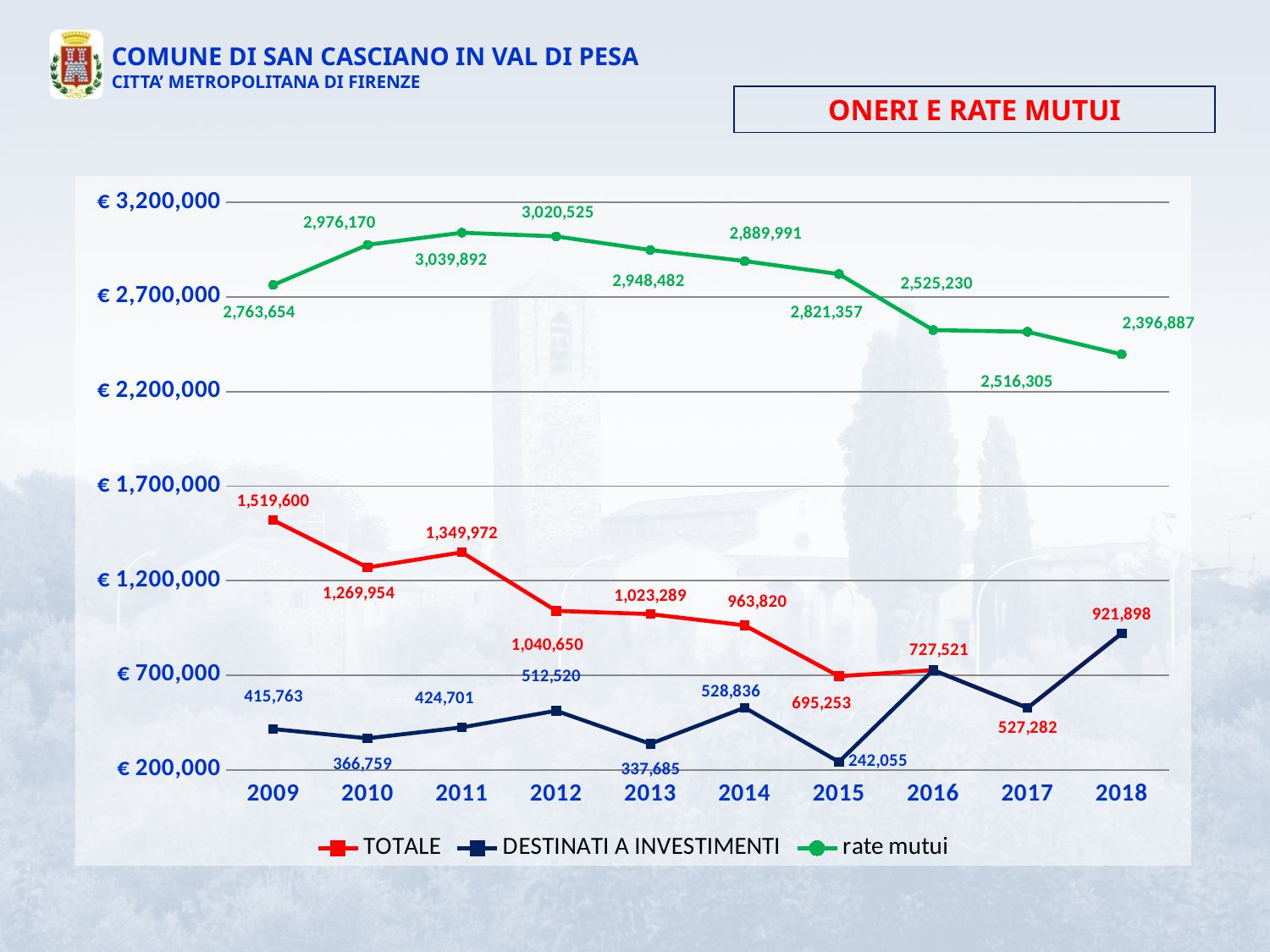
What is the TOTALE value for 2018? 921,898 Does the rate mutui series rise or fall from 2012 to 2018? Fall What is the value of rate mutui in 2011? 3,039,892 What is the TOTALE value for 2009? 1,519,600 How many years are shown on the x axis? 10 How many series does the legend list? 3 What is the difference between rate mutui in 2009 and in 2018? 366,767 In which year is the TOTALE series at its lowest? 2017 What kind of chart is shown on the slide? Line chart Which is larger for DESTINATI A INVESTIMENTI: 2012 or 2014? 2014 In which year is rate mutui at its highest? 2011 What is the DESTINATI A INVESTIMENTI value in 2015? 242,055